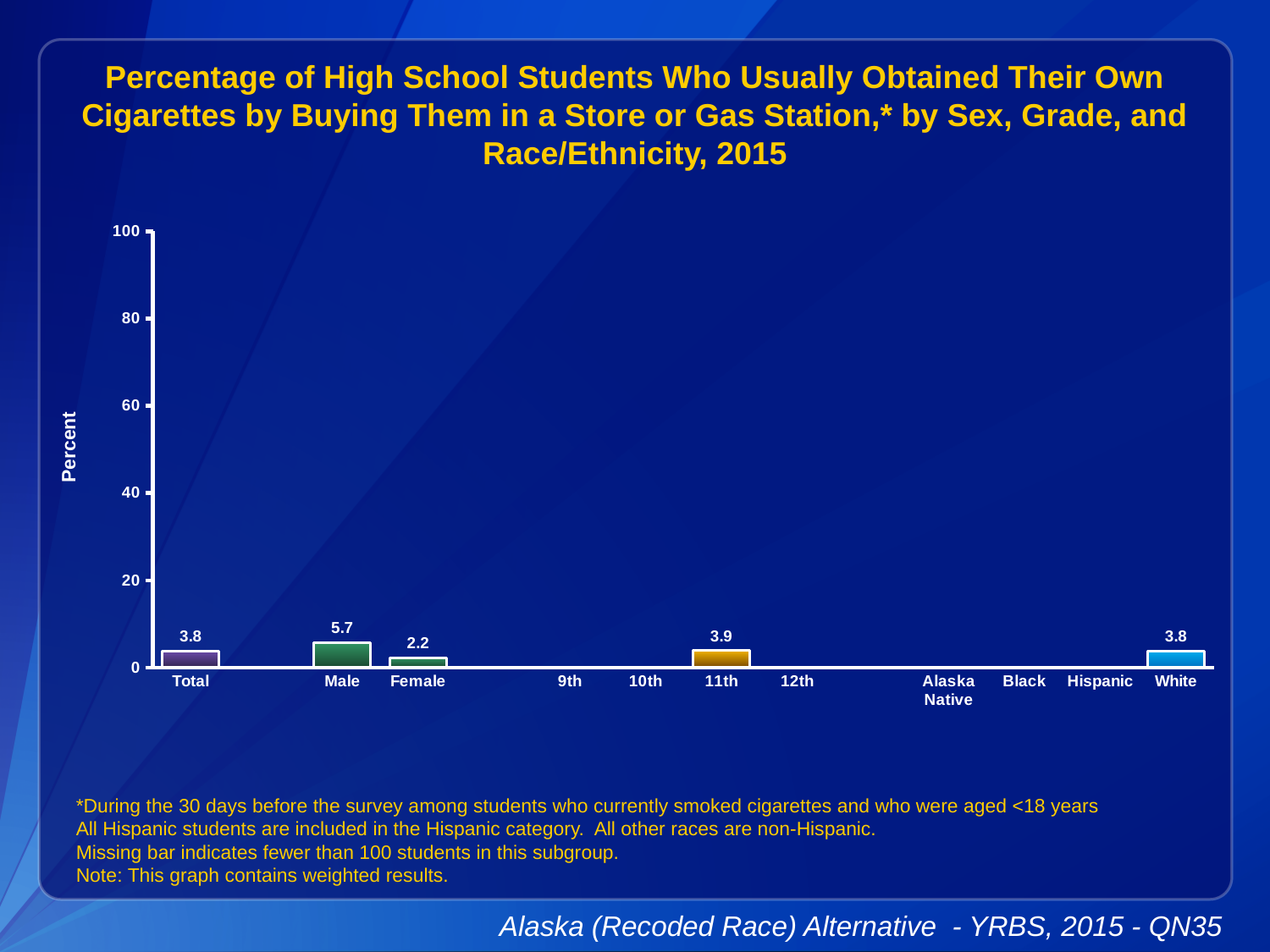
What is the value for Male? 5.7 What is the value for 11th grade? 3.9 Is the value for Total greater or less than 20? less Which is larger, the value for Male or the value for Female? Male What is the value for Female? 2.2 What kind of chart is shown on the slide? bar chart How many category labels are shown on the x axis? 11 What is the label on the y axis? Percent What is the value for White? 3.8 Among the categories with a bar shown, which has the lowest value? Female Which category has the highest bar? Male What is the difference between the Male and Female values? 3.5